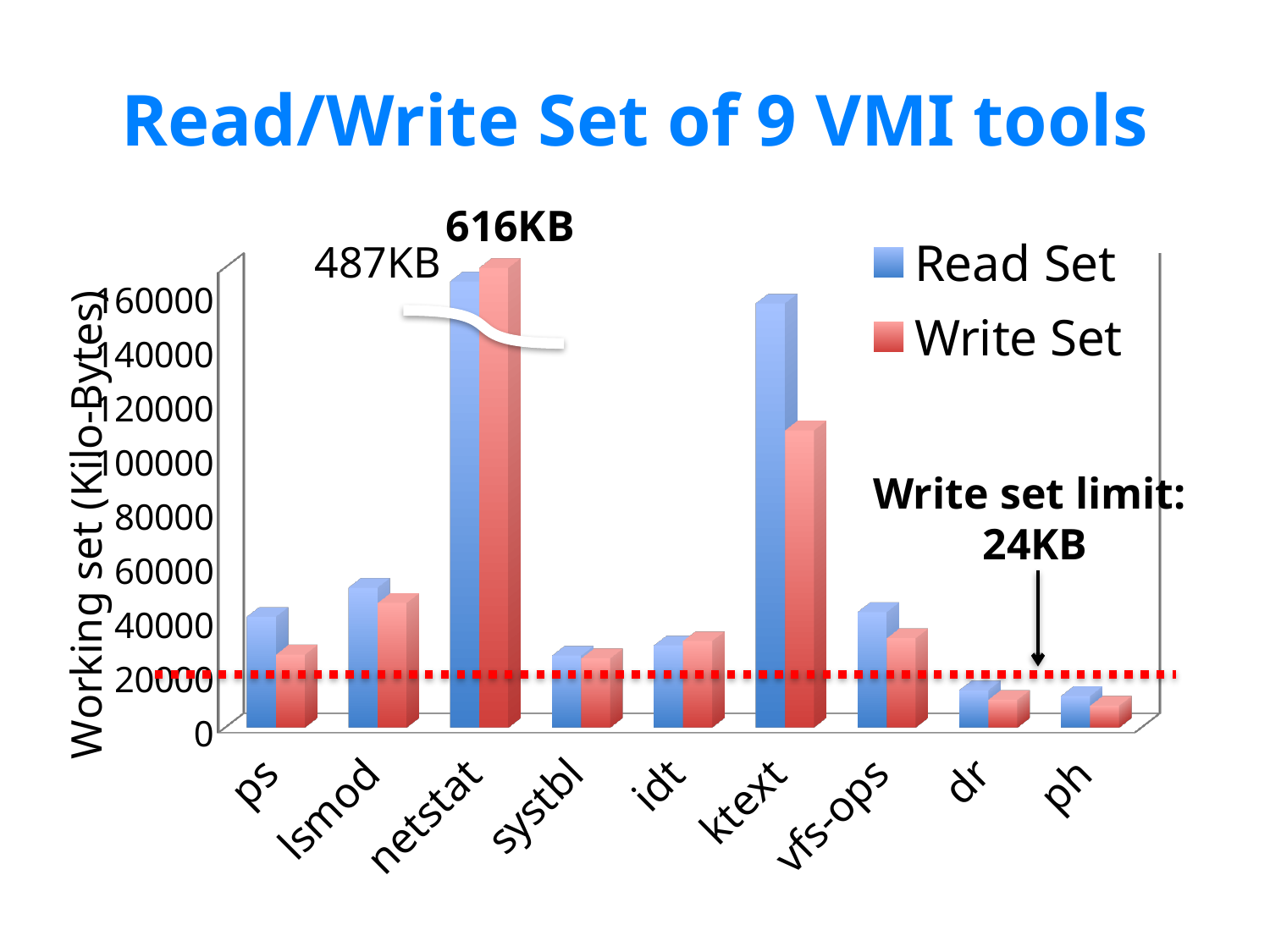
Is the Read Set value for dr greater or less than 20000? less What value is labelled above the Write Set bar for netstat? 616KB Which tool has the highest Read Set value? netstat What write set limit is annotated on the chart? 24KB For ktext, which is larger: the Read Set or the Write Set? Read Set What value is labelled above the Read Set bar for netstat? 487KB Is the Write Set value for ktext greater or less than 80000? greater For ps, which is larger: the Read Set or the Write Set? Read Set How many VMI tools (categories) are shown on the x axis? 9 How many series does the legend list? 2 Which tool has the highest Write Set value? netstat What kind of chart is shown on the slide? bar chart